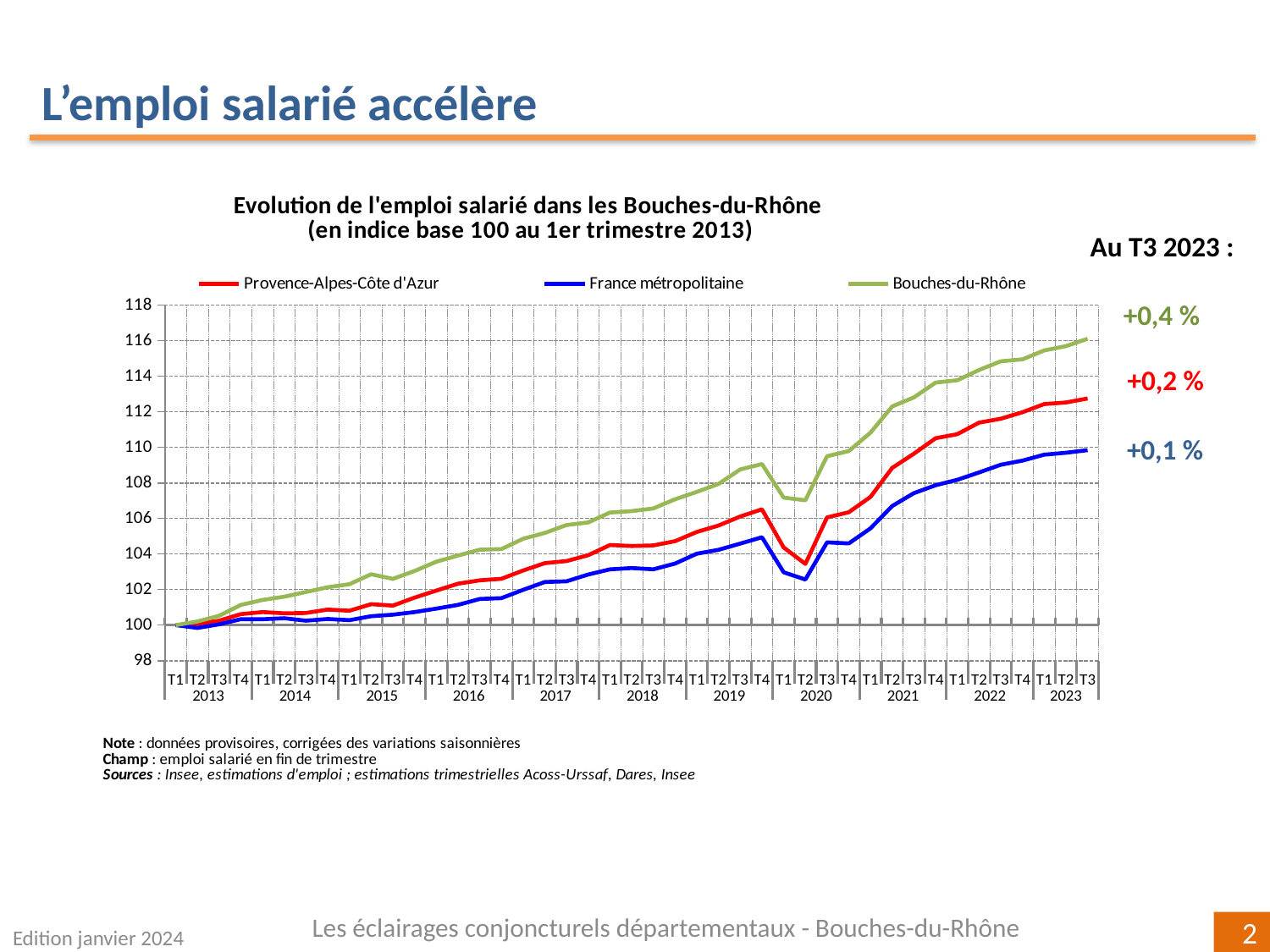
What kind of chart is shown on the slide? line chart What change at T3 2023 is annotated for France métropolitaine (blue)? +0,1 % Do the values generally rise or fall from 2013 to 2023? rise What is the title of the chart? Evolution de l'emploi salarié dans les Bouches-du-Rhône (en indice base 100 au 1er trimestre 2013) Which series has the highest value at T3 2023? Bouches-du-Rhône How many series does the legend list? 3 Which series has the lowest value at T3 2023? France métropolitaine Is the value for Provence-Alpes-Côte d'Azur at T3 2023 greater or less than 110? greater In which year do all three series show a sharp drop? 2020 What change at T3 2023 is annotated for Bouches-du-Rhône (green)? +0,4 % Is the value for France métropolitaine at T3 2023 greater or less than 112? less Is the value for Bouches-du-Rhône at T3 2023 greater or less than 114? greater